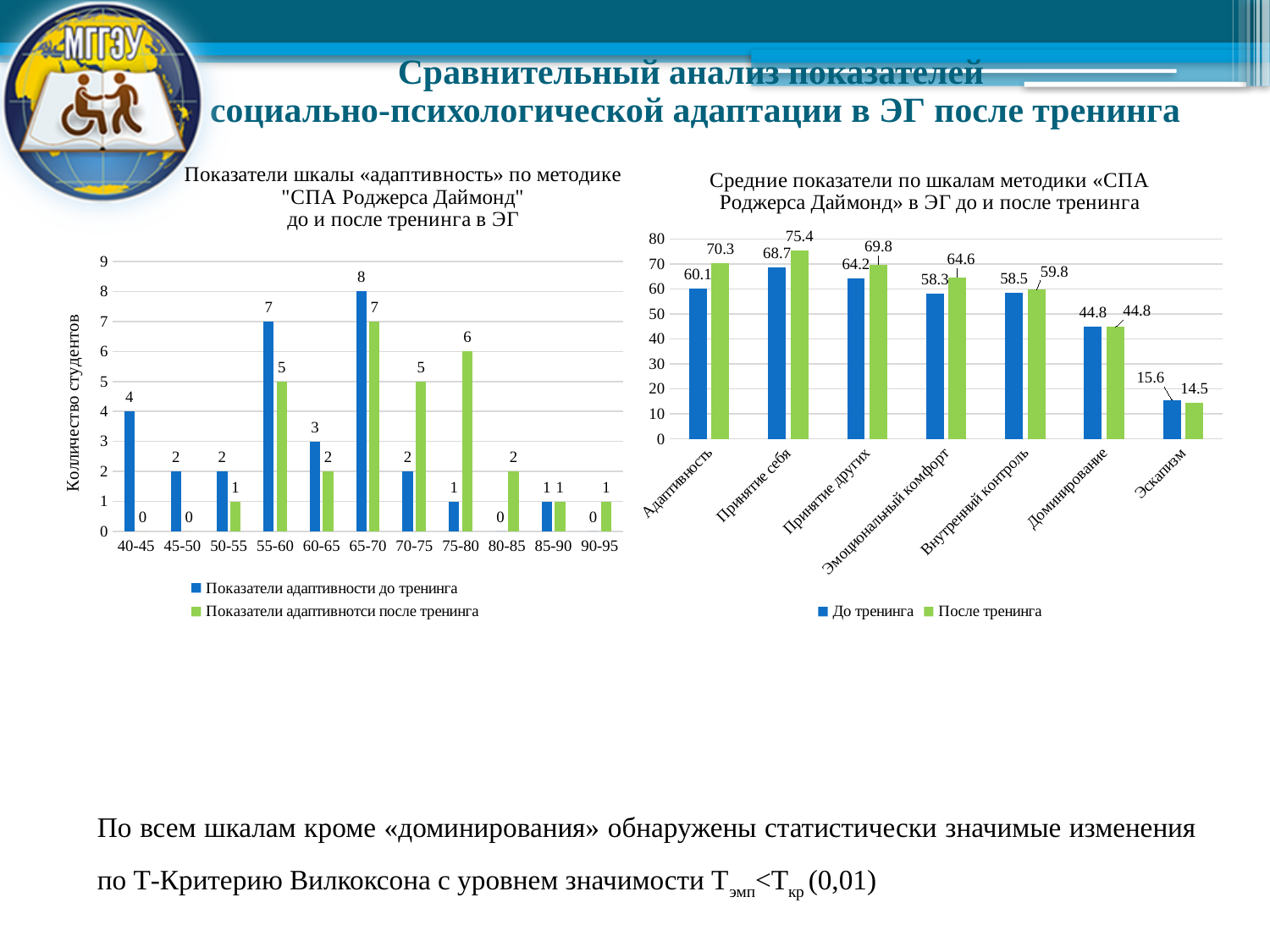
In the right chart (Средние показатели по шкалам методики «СПА Роджерса Даймонд»), what is the value for Адаптивность after training (После тренинга)? 70.3 What type of chart is the left chart? bar chart How many categories are shown on the x axis of the right chart? 7 In the right chart, what is the value for Эскапизм before training (До тренинга)? 15.6 How many ranges are shown on the x axis of the left chart? 11 In the right chart, is the value for Доминирование before training larger, smaller, or equal to the value after training? equal In the right chart, which category has the highest value after training (После тренинга)? Принятие себя In the right chart, which category has the lowest value before training (До тренинга)? Эскапизм In the left chart, what is the value for the 75-80 range after training? 6 In the left chart, which range has the highest value for Показатели адаптивности до тренинга? 65-70 In the left chart (Показатели шкалы «адаптивность»), what is the value for the 65-70 range before training? 8 In the right chart, what is the difference between the after-training and before-training values for Адаптивность? 10.2